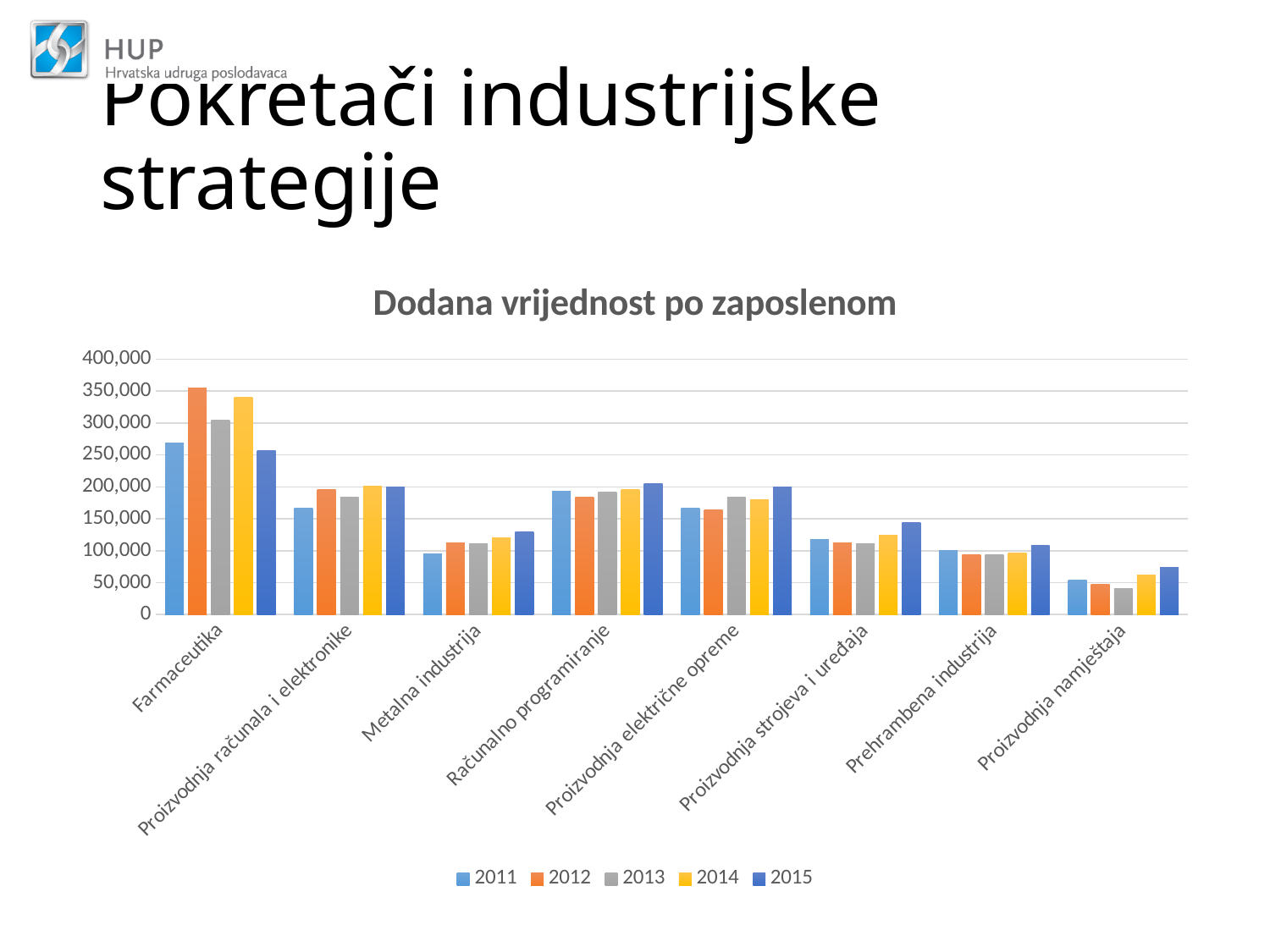
For Farmaceutika, which is larger: the 2012 value or the 2013 value? 2012 Is the value for Metalna industrija in 2015 greater or less than 100,000? greater Is the value for Farmaceutika in 2011 greater or less than 250,000? greater Which year has the highest bar for Farmaceutika? 2012 How many industry categories are shown on the x axis? 8 What type of chart is shown on the slide? Bar chart Which category has the lowest value for 2015? Proizvodnja namještaja What is the title of the chart? Dodana vrijednost po zaposlenom Which category has the highest value for 2011? Farmaceutika For Proizvodnja namještaja, which is larger: the 2011 value or the 2015 value? 2015 How many series does the legend list? 5 Is the value for Proizvodnja namještaja in 2015 greater or less than 50,000? greater